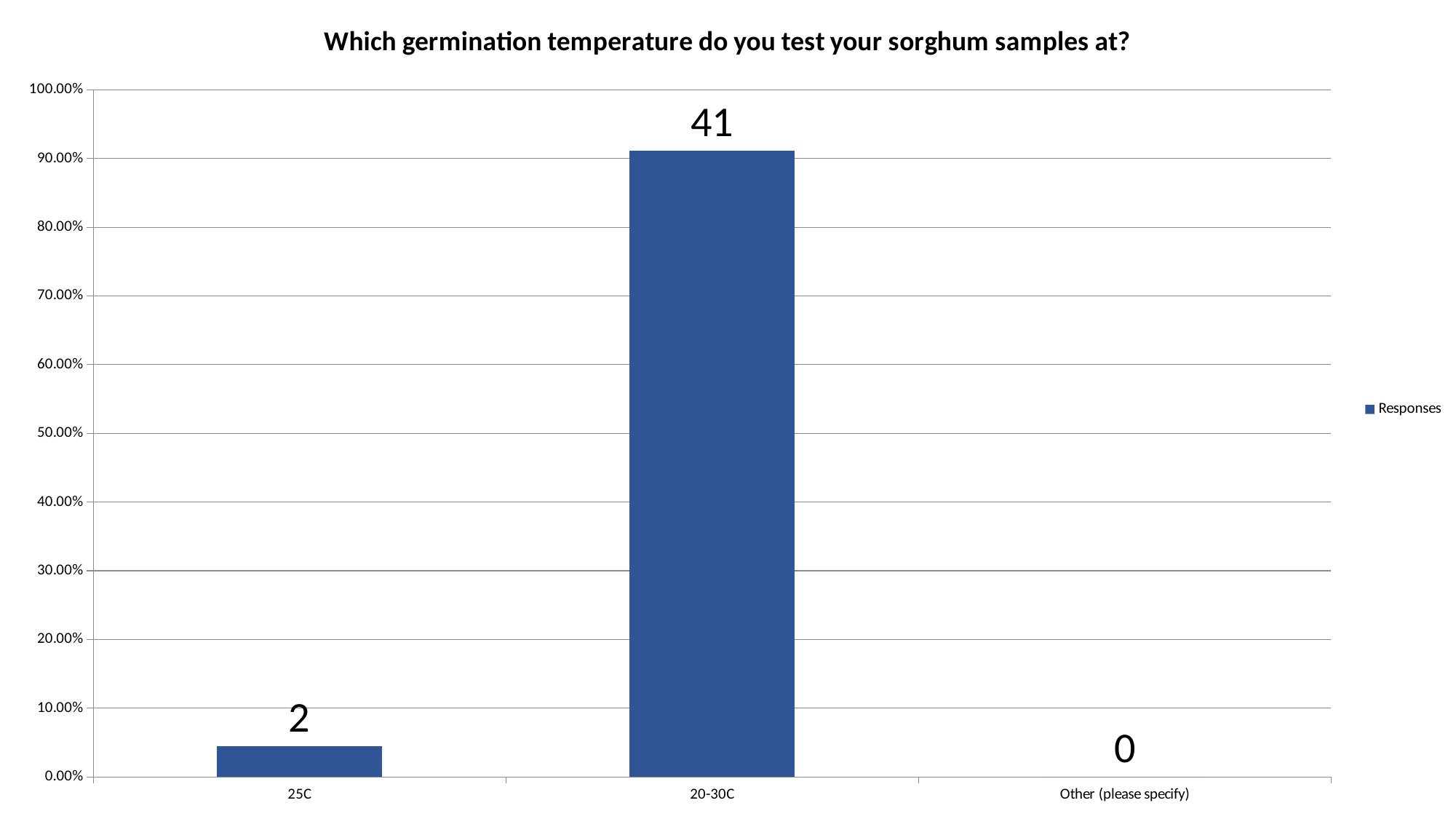
What is the difference between the data labels for 20-30C and 25C? 39 Is the bar for 20-30C greater or less than 80.00% on the axis? greater What kind of chart is shown on the slide? bar chart Which category has the lowest number of responses? Other (please specify) How many categories are shown on the x axis of the chart? 3 How many series does the legend list? 1 What is the title of the chart? Which germination temperature do you test your sorghum samples at? What data label is shown for Other (please specify)? 0 What is the name of the series shown in the legend? Responses Which category has the highest number of responses? 20-30C What data label is shown above the bar for 25C? 2 What data label is shown above the bar for 20-30C? 41